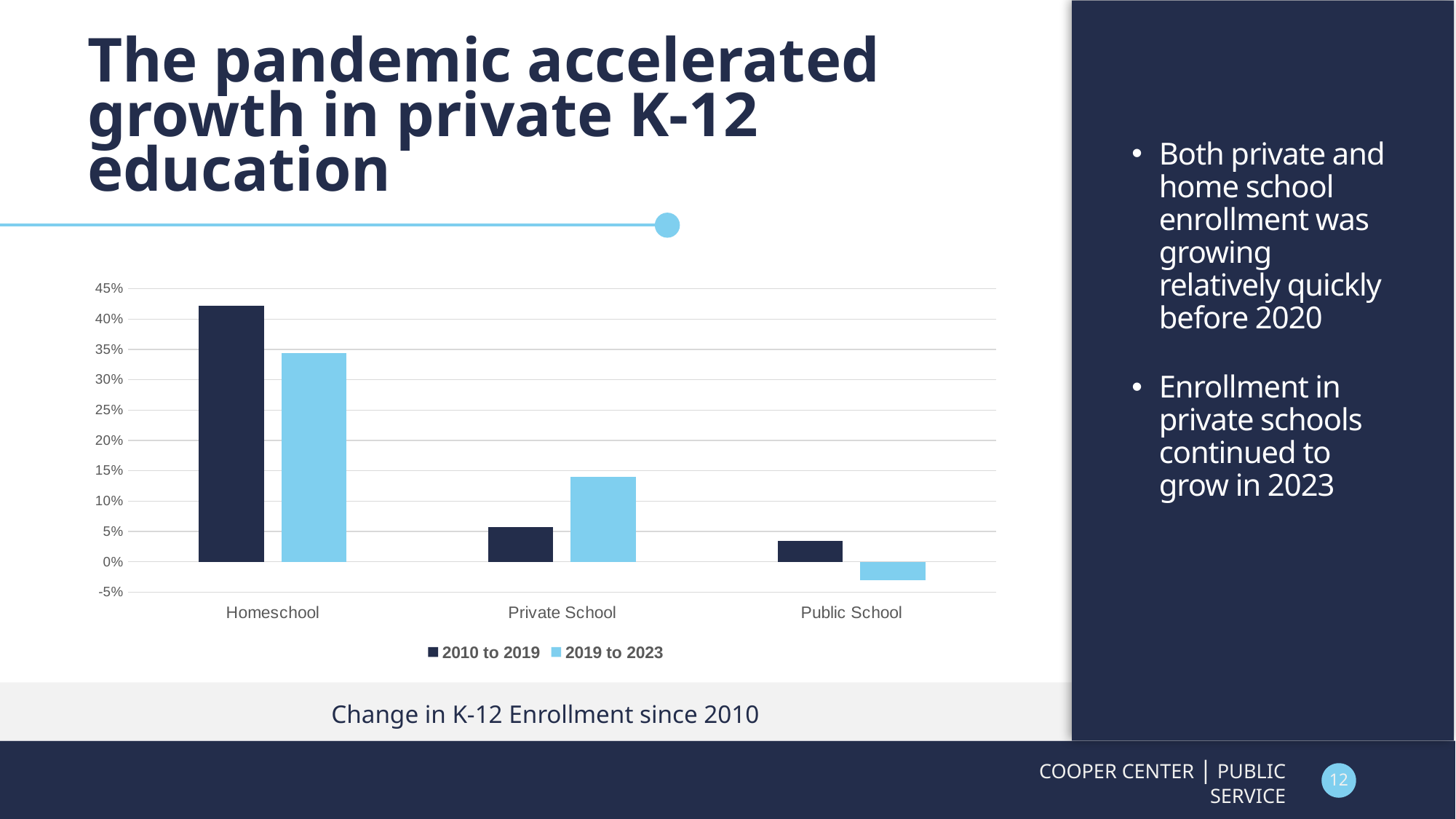
For Homeschool, which series has the larger value: 2010 to 2019 or 2019 to 2023? 2010 to 2019 Which category has the highest value for the 2010 to 2019 series? Homeschool Is the 2019 to 2023 value for Public School greater or less than 0%? less How many series does the chart's legend list? 2 Is the 2019 to 2023 value for Homeschool greater or less than 30%? greater What caption is shown below the chart? Change in K-12 Enrollment since 2010 How many categories are shown on the x axis of the chart? 3 For Private School, which series has the larger value: 2010 to 2019 or 2019 to 2023? 2019 to 2023 What kind of chart is shown on the slide? bar chart Which category has the lowest value for the 2019 to 2023 series? Public School Is the 2019 to 2023 value for Private School greater or less than 10%? greater